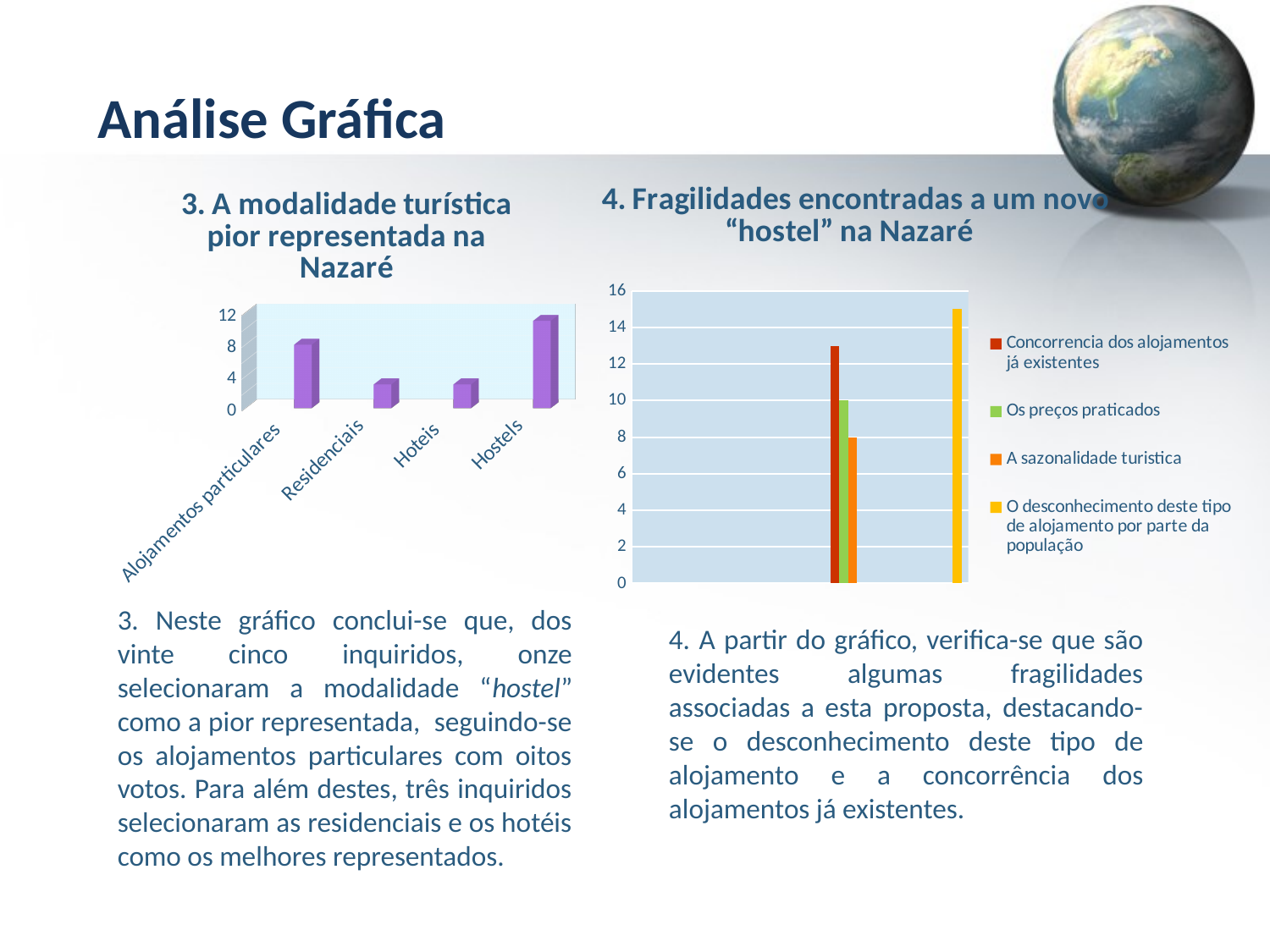
In the chart titled "4. Fragilidades encontradas a um novo “hostel” na Nazaré", which series has the highest value? O desconhecimento deste tipo de alojamento por parte da população In the chart titled "3. A modalidade turística pior representada na Nazaré", which category has the highest value? Hostels In the chart titled "3. A modalidade turística pior representada na Nazaré", how many categories are shown on the x axis? 4 In the chart titled "4. Fragilidades encontradas a um novo “hostel” na Nazaré", is the value for O desconhecimento deste tipo de alojamento por parte da população greater or less than 14? greater In the chart titled "3. A modalidade turística pior representada na Nazaré", which is larger: the value for Alojamentos particulares or the value for Hoteis? Alojamentos particulares In the chart titled "4. Fragilidades encontradas a um novo “hostel” na Nazaré", how many series does the legend list? 4 In the chart titled "3. A modalidade turística pior representada na Nazaré", what kind of chart is shown? Bar chart In the chart titled "4. Fragilidades encontradas a um novo “hostel” na Nazaré", which series has the lowest value? A sazonalidade turistica In the chart titled "3. A modalidade turística pior representada na Nazaré", is the value for Residenciais greater or less than 4? less In the chart titled "4. Fragilidades encontradas a um novo “hostel” na Nazaré", is the value for Concorrencia dos alojamentos já existentes greater or less than 12? greater In the chart titled "4. Fragilidades encontradas a um novo “hostel” na Nazaré", what colour represents the series Concorrencia dos alojamentos já existentes? Red